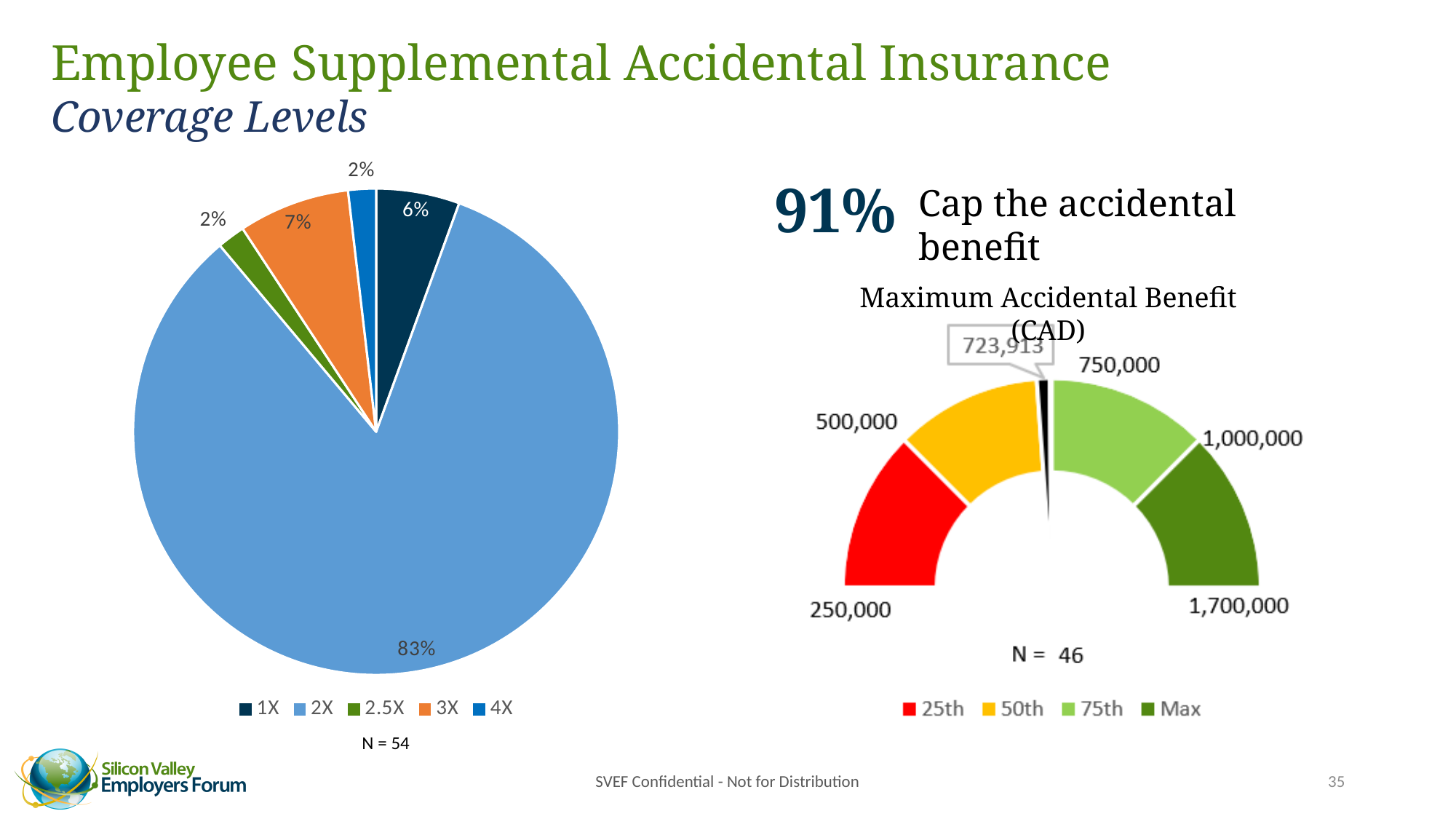
In the pie chart on the left, what percentage of respondents offer 1X coverage? 6% In the pie chart on the left, which coverage level has the largest share? 2X In the pie chart on the left, which is larger: the share for 1X or the share for 3X? 3X How many coverage levels are listed in the legend of the pie chart on the left? 5 In the pie chart on the left, what percentage of respondents offer 2X coverage? 83% In the Maximum Accidental Benefit (CAD) chart on the right, what is the highest value labelled on the gauge? 1,700,000 In the Maximum Accidental Benefit (CAD) chart on the right, what value does the needle point to? 723,913 How many entries are in the legend of the Maximum Accidental Benefit (CAD) chart on the right? 4 What type of chart is shown on the left of the slide? Pie chart What is the sample size (N) shown below the Maximum Accidental Benefit (CAD) chart on the right? 46 In the pie chart on the left, what percentage of respondents offer 3X coverage? 7% In the pie chart on the left, what is the difference in percentage points between the 2X share and the 3X share? 76%